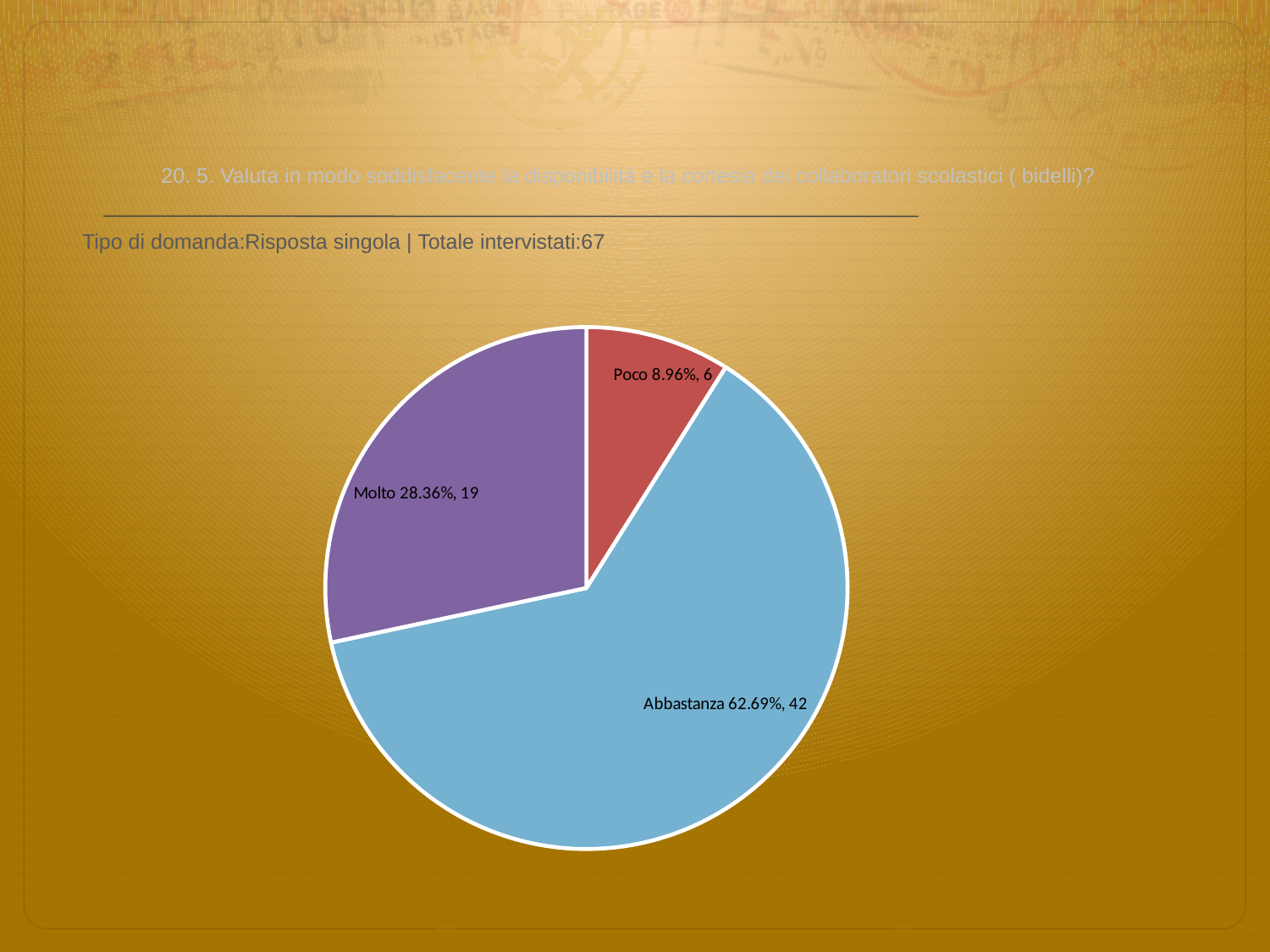
What percentage of respondents answered "Abbastanza"? 62.69% What percentage of respondents answered "Poco"? 8.96% What is the total number of respondents across all three slices? 67 How many slices does the pie chart have? 3 How many respondents answered "Molto"? 19 Which response has the largest share of the pie? Abbastanza Which response has the smallest share of the pie? Poco Which response received more answers, "Molto" or "Poco"? Molto What is the difference in number of respondents between "Abbastanza" and "Molto"? 23 What kind of chart is shown on the slide? pie chart What colour is the "Molto" slice? purple How many respondents answered "Abbastanza"? 42